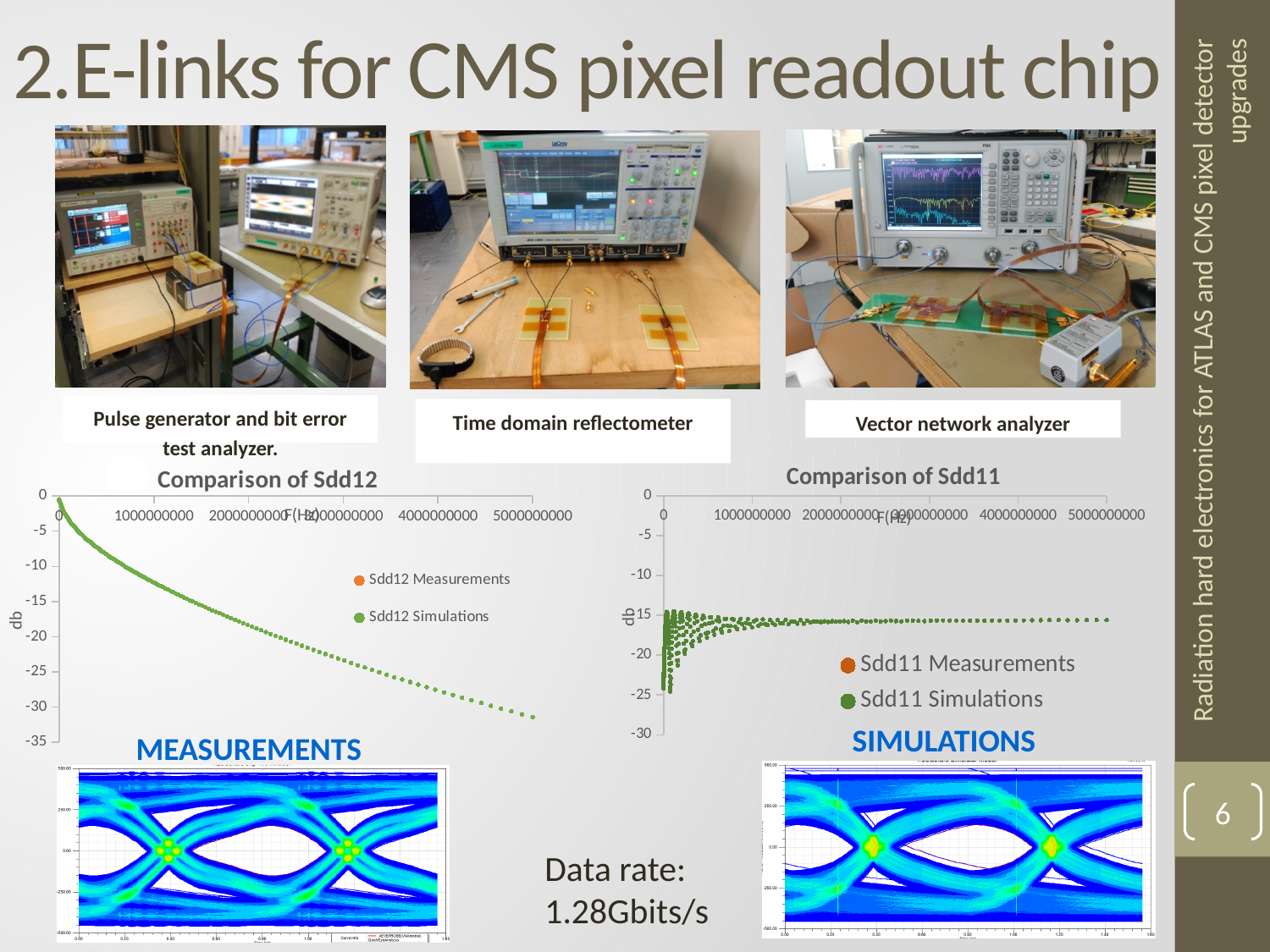
In the 'Comparison of Sdd12' chart, do the plotted values rise or fall as frequency increases along the x axis? fall In the 'Comparison of Sdd12' chart, is the value at 4000000000 Hz greater or less than -25 db? less How many series does the legend of the 'Comparison of Sdd12' chart list? 2 What kind of chart is the 'Comparison of Sdd12' chart? scatter chart What kind of chart is the 'Comparison of Sdd11' chart? scatter chart What are the two legend entries of the 'Comparison of Sdd11' chart? Sdd11 Measurements and Sdd11 Simulations How many series does the legend of the 'Comparison of Sdd11' chart list? 2 What is the lowest y-axis tick value shown on the 'Comparison of Sdd12' chart? -35 What is the x-axis label on the 'Comparison of Sdd12' chart? F(Hz) In the 'Comparison of Sdd11' chart, is the value at 4000000000 Hz greater or less than -20 db? greater In the 'Comparison of Sdd12' chart, is the value at 500000000 Hz greater or less than -15 db? greater What is the highest x-axis tick value shown on the 'Comparison of Sdd11' chart? 5000000000